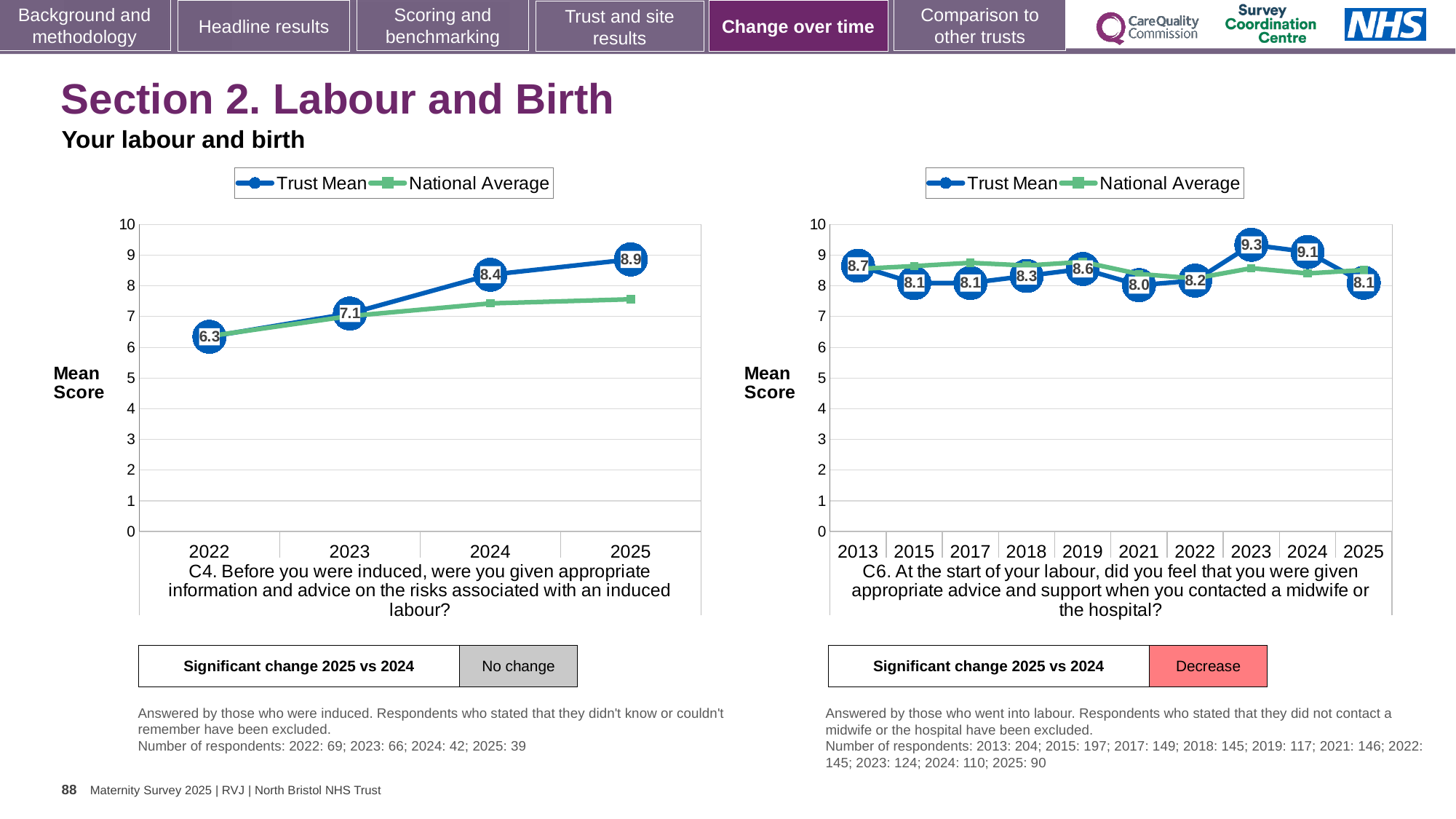
In the C6 chart on the right, how many series does the legend list? 2 In the C6 chart on the right, which year has the lowest Trust Mean? 2021 In the C6 chart on the right, what is the difference between the Trust Mean in 2024 and in 2025? 1.0 In the C4 chart on the left, how many years are shown on the x axis? 4 In the C4 chart on the left, what is the Trust Mean for 2025? 8.9 What type of chart is the C6 chart on the right? line chart In the C6 chart on the right, what is the Trust Mean for 2023? 9.3 In the C6 chart on the right, which year has the highest Trust Mean? 2023 In the C4 chart on the left, what is the Trust Mean for 2022? 6.3 In the C4 chart on the left, what is the difference between the Trust Mean in 2025 and in 2022? 2.6 In the C4 chart on the left, does the Trust Mean rise or fall from 2022 to 2025? rise In the C4 chart on the left, is the National Average for 2025 greater or less than 8? less